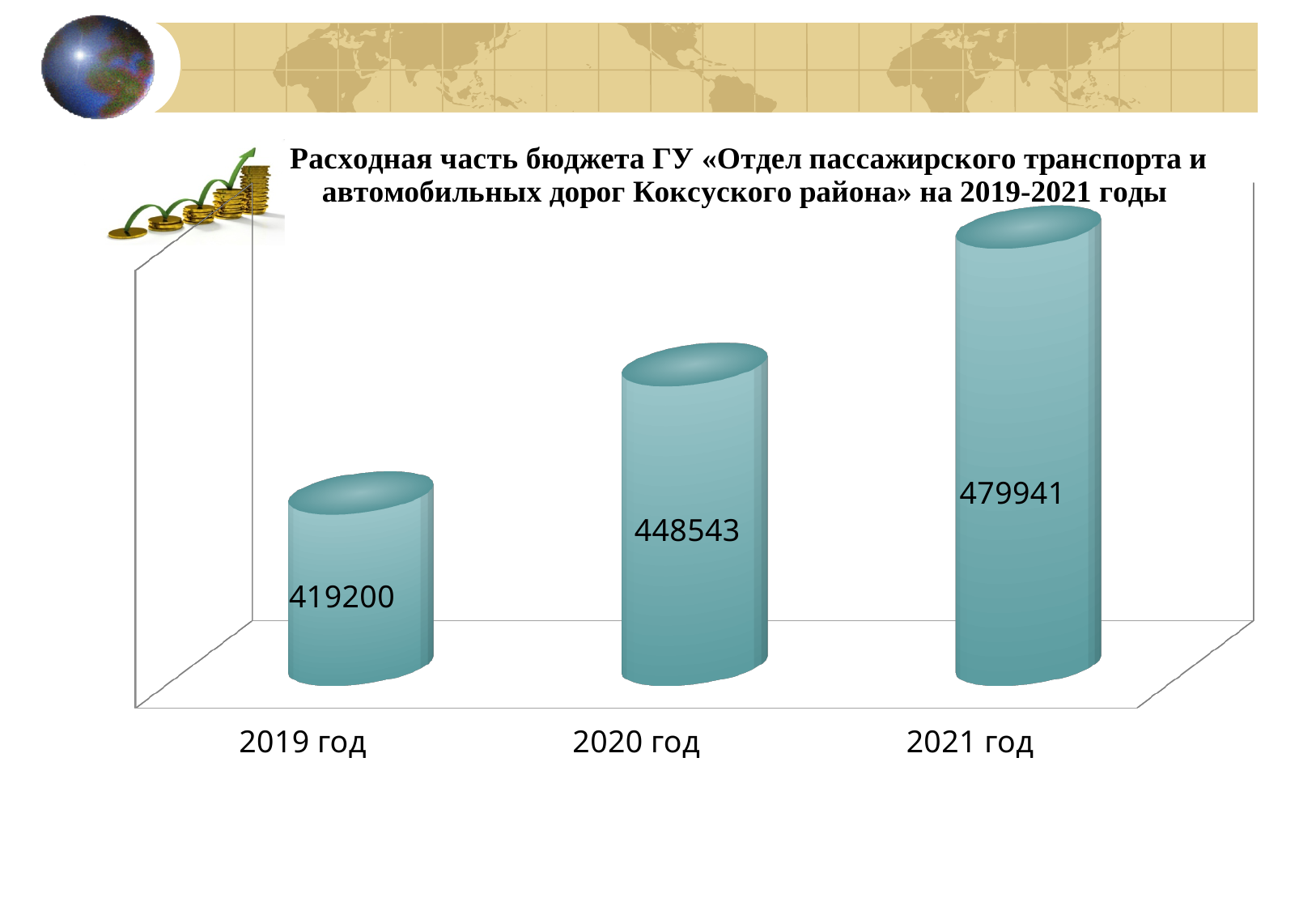
What is the difference between the values for 2020 год and 2019 год? 29343 Which year has the highest value? 2021 год What is the value for 2021 год? 479941 What is the value for 2019 год? 419200 What kind of chart is shown on the slide? bar chart What is the value for 2020 год? 448543 Which year has the lowest value? 2019 год Do the values rise or fall from 2019 год to 2021 год? rise Which is larger, the value for 2020 год or the value for 2021 год? 2021 год What is the difference between the values for 2021 год and 2019 год? 60741 What is the difference between the values for 2021 год and 2020 год? 31398 How many categories are shown on the chart? 3